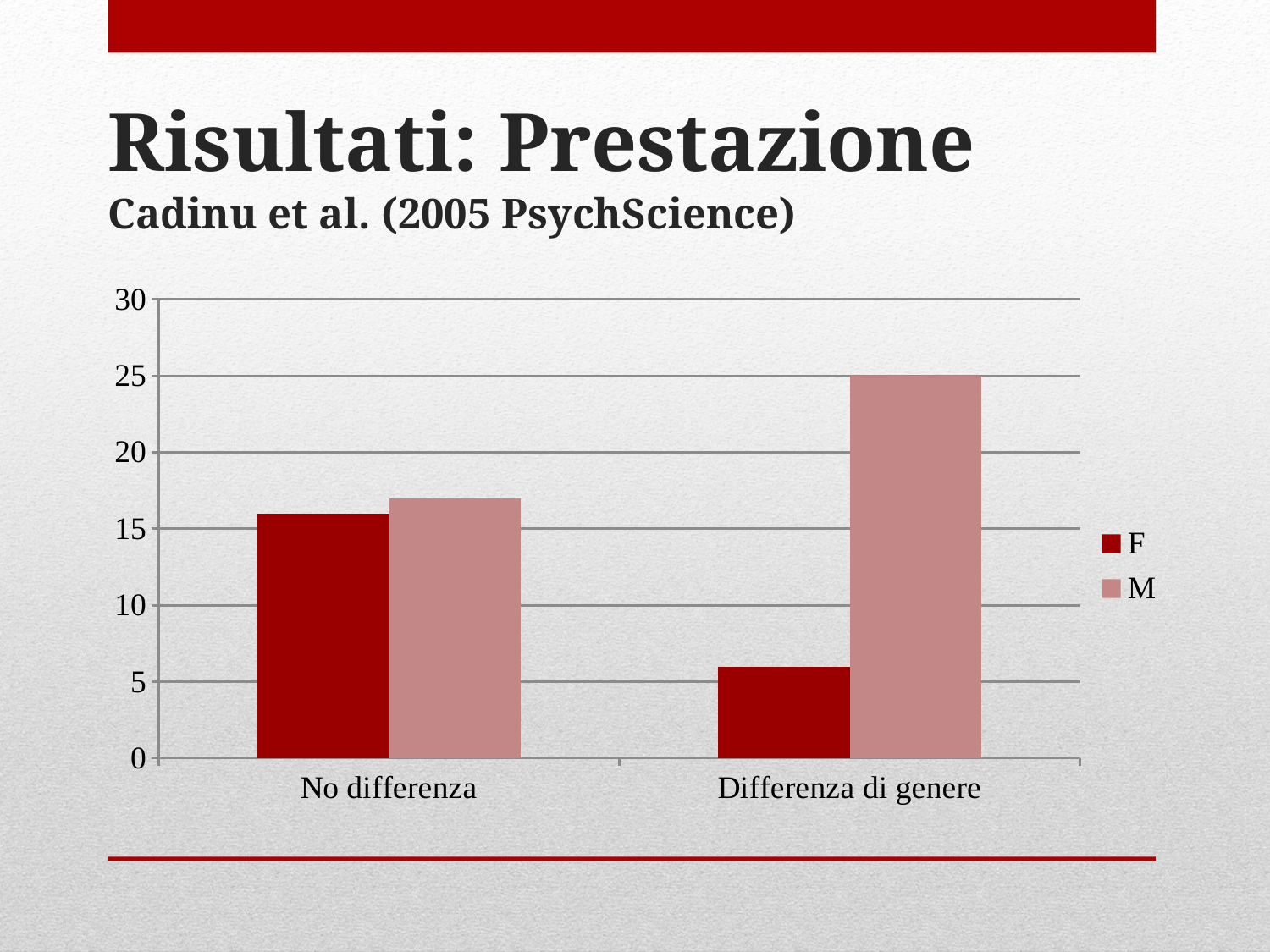
For series F, which category has the larger value: No differenza or Differenza di genere? No differenza How many series does the legend list? 2 Is the value for M in the No differenza category greater or less than 20? less How many categories are shown on the x axis? 2 What is the value for M in the Differenza di genere category? 25 Which bar is the tallest in the chart? M, Differenza di genere Which bar is the shortest in the chart? F, Differenza di genere What are the two series named in the legend? F and M What kind of chart is shown on the slide? bar chart Is the value for F in the Differenza di genere category greater or less than 10? less In the Differenza di genere category, which series has the larger value, F or M? M Is the value for F in the No differenza category greater or less than 15? greater